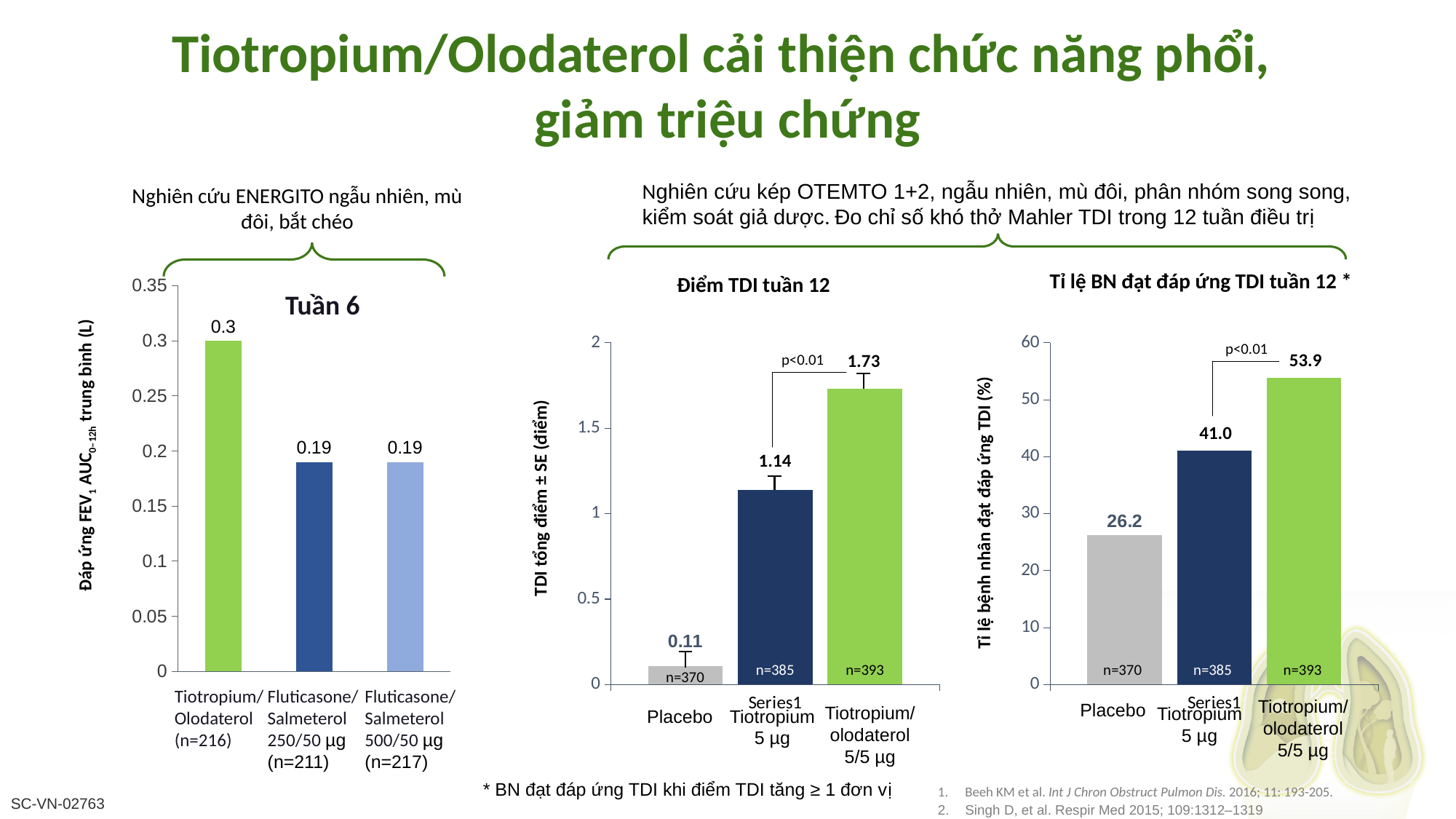
What kind of chart is the middle chart (Điểm TDI tuần 12)? Bar chart In the right chart (Tỉ lệ BN đạt đáp ứng TDI tuần 12), which is larger: Placebo or Tiotropium/olodaterol 5/5 µg? Tiotropium/olodaterol 5/5 µg In the middle chart (Điểm TDI tuần 12), which category has the lowest value? Placebo In the middle chart (Điểm TDI tuần 12), what is the value for Placebo? 0.11 In the right chart (Tỉ lệ BN đạt đáp ứng TDI tuần 12), what is the difference between Tiotropium/olodaterol 5/5 µg and Placebo? 27.7 In the middle chart (Điểm TDI tuần 12), what is the difference between Tiotropium/olodaterol 5/5 µg and Tiotropium 5 µg? 0.59 In the left chart (Tuần 6), how many bars are plotted? 3 In the middle chart (Điểm TDI tuần 12), what is the value for Tiotropium/olodaterol 5/5 µg? 1.73 In the right chart (Tỉ lệ BN đạt đáp ứng TDI tuần 12), what is the value for Tiotropium 5 µg? 41.0 In the left chart (Tuần 6), what is the difference between Tiotropium/Olodaterol and Fluticasone/Salmeterol 250/50 µg? 0.11 In the left chart (Tuần 6), what is the value for Tiotropium/Olodaterol (n=216)? 0.3 In the left chart (Tuần 6), which category has the highest value? Tiotropium/Olodaterol (n=216)